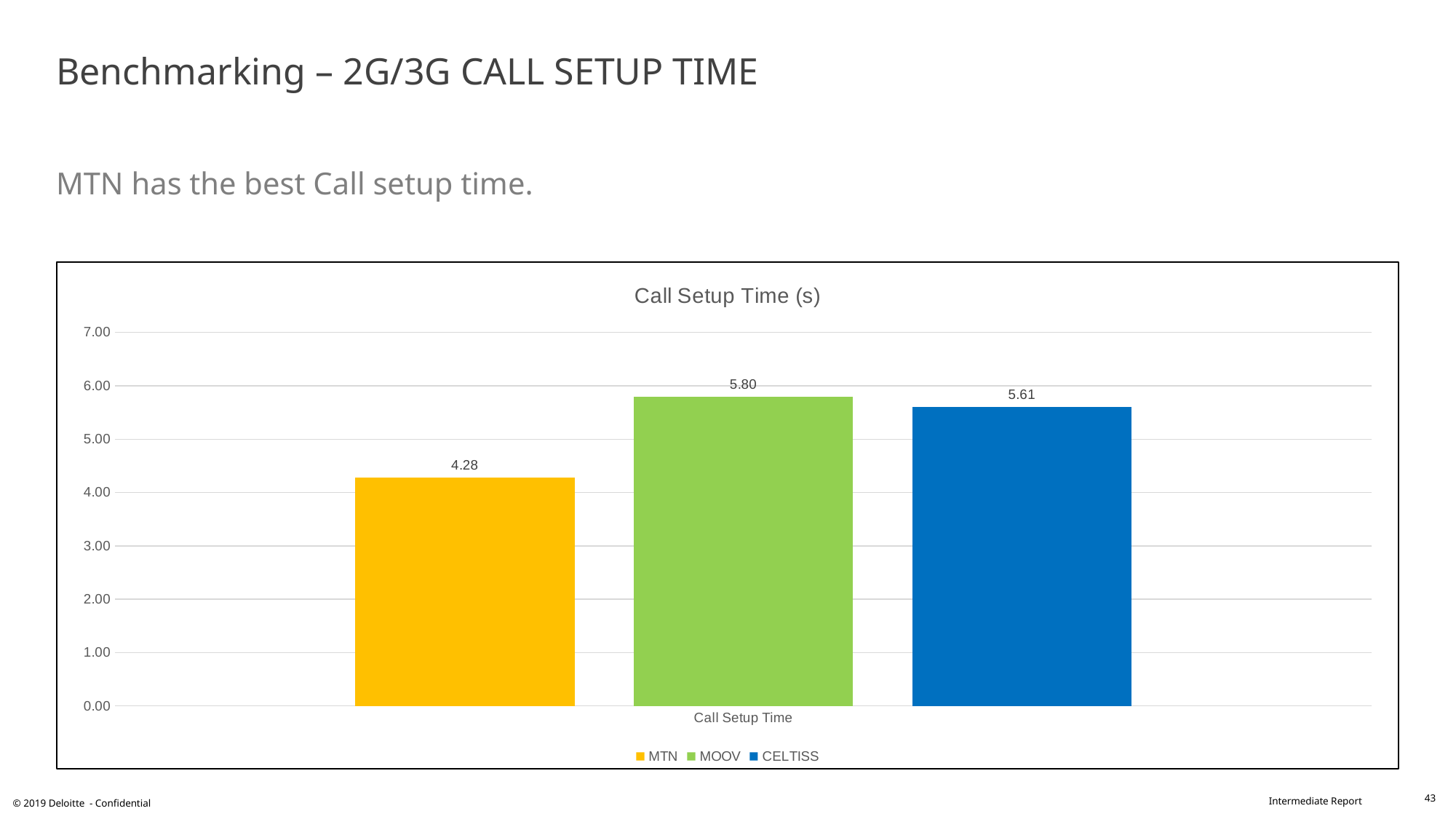
What kind of chart is shown on the slide? bar chart How many series does the legend list? 3 Which operator has the highest call setup time? MOOV What is the difference between the call setup times of MOOV and CELTISS? 0.19 What is the call setup time for MOOV? 5.80 Which operator has the lowest call setup time? MTN What is the call setup time for MTN? 4.28 Which has a larger call setup time, CELTISS or MTN? CELTISS What is the difference between the call setup times of MOOV and MTN? 1.52 What is the title of the chart? Call Setup Time (s) Is the call setup time for MTN greater or less than 5.00? less What is the call setup time for CELTISS? 5.61